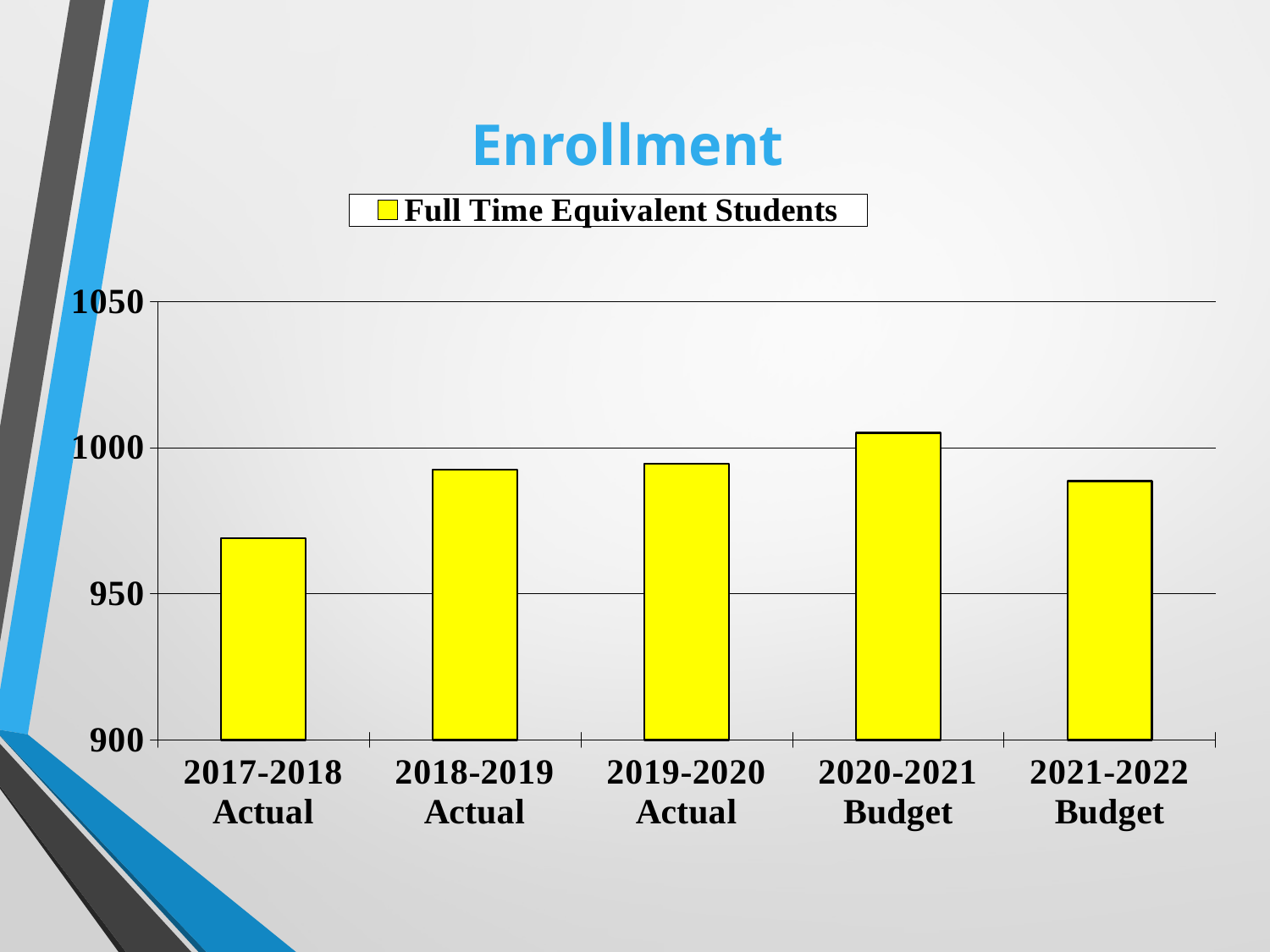
How many categories are shown on the x axis of the chart? 5 Is the value for 2017-2018 Actual greater or less than 1000? less Which is larger, the value for 2020-2021 Budget or the value for 2021-2022 Budget? 2020-2021 Budget How many series does the chart's legend list? 1 Do the values rise or fall from 2017-2018 Actual to 2020-2021 Budget? rise Which category has the lowest value in the chart? 2017-2018 Actual Which category has the highest value in the chart? 2020-2021 Budget Is the value for 2021-2022 Budget greater or less than 1000? less Is the value for 2018-2019 Actual greater or less than 1000? less Which is larger, the value for 2017-2018 Actual or the value for 2021-2022 Budget? 2021-2022 Budget What kind of chart is shown on the slide? bar chart